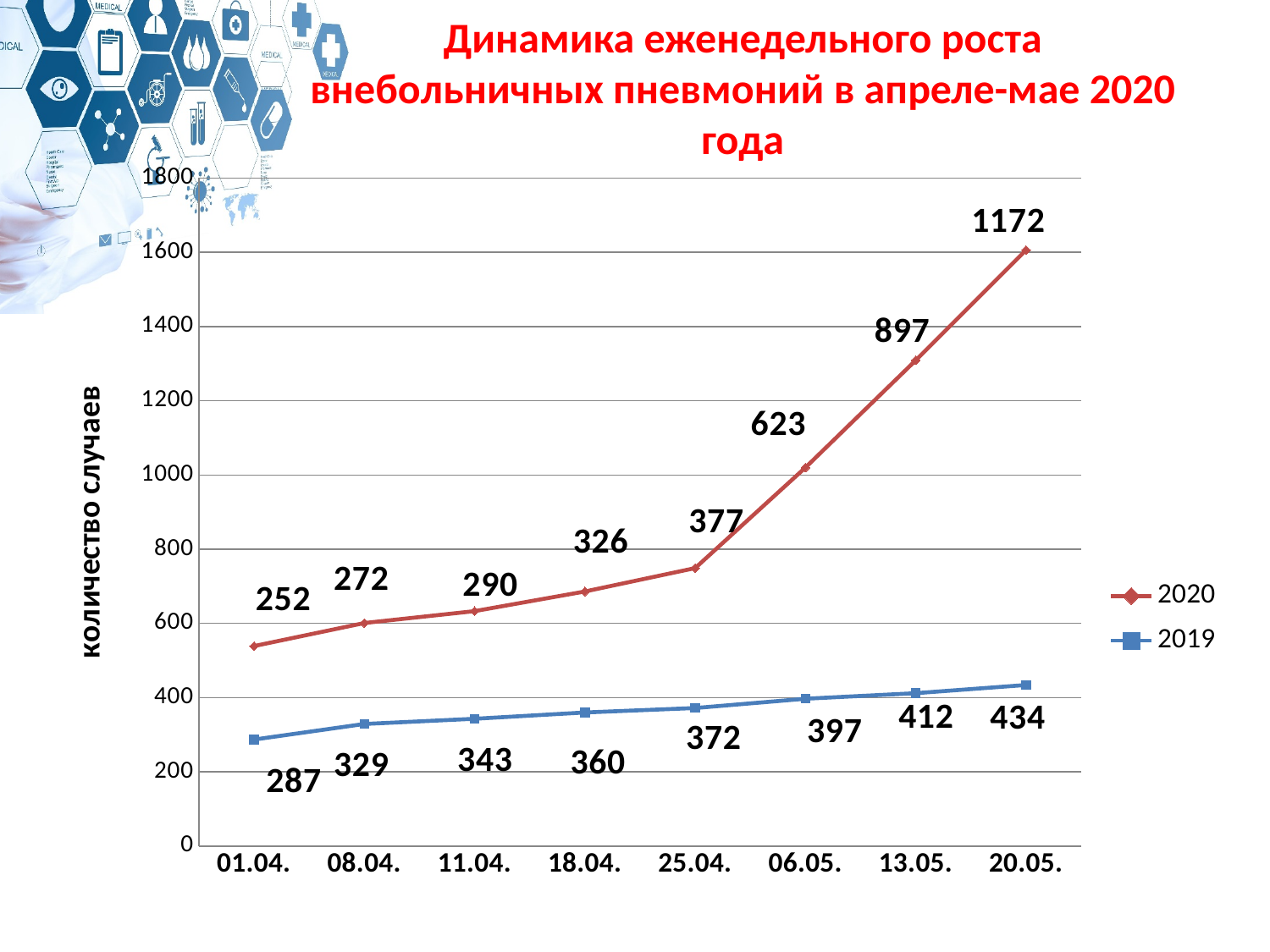
By how much does the 2020 value at 13.05. exceed the 2020 value at 06.05.? 274 How many dates are plotted along the x axis? 8 At which date does the 2020 series reach its highest value? 20.05. What is the value for the 2020 series at 25.04.? 377 Do the values of the 2020 series rise or fall from 01.04. to 20.05.? rise At which date is the 2019 series at its lowest value? 01.04. What is the difference between the 2020 and 2019 values at 20.05.? 738 What kind of chart is shown on the slide? line chart How many series does the legend list? 2 What is the value for the 2020 series at 20.05.? 1172 At 01.04., which series has the larger value, 2020 or 2019? 2019 What is the value for the 2019 series at 01.04.? 287